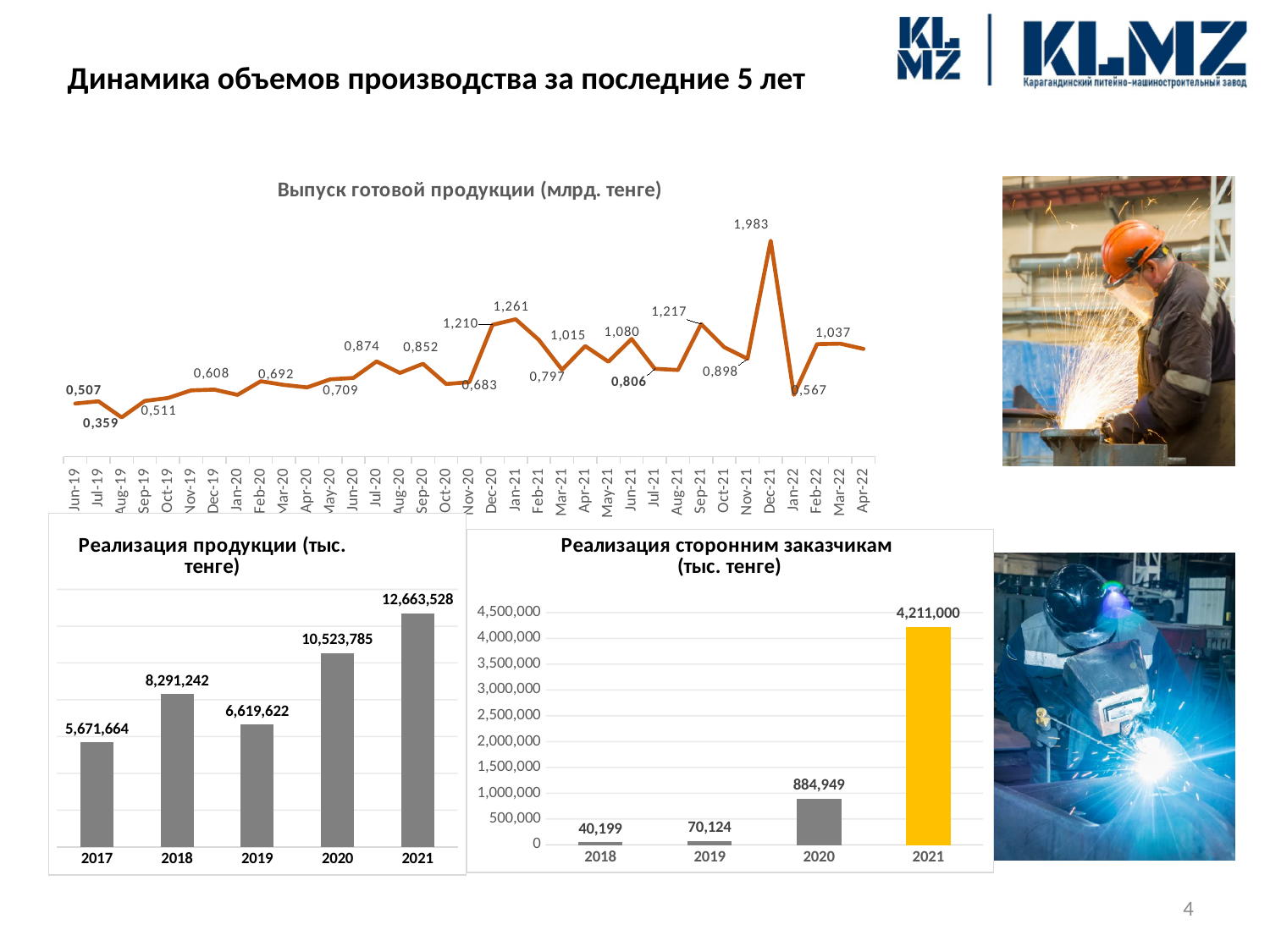
In the chart 'Реализация сторонним заказчикам (тыс. тенге)', is the value for 2021 greater or less than 4,000,000? greater In the chart 'Реализация продукции (тыс. тенге)', which year has the lowest value? 2017 In the chart 'Реализация сторонним заказчикам (тыс. тенге)', what is the difference between the 2019 and 2018 values? 29,925 How many years are shown in the chart 'Реализация сторонним заказчикам (тыс. тенге)'? 4 In the chart 'Реализация продукции (тыс. тенге)', what is the difference between the 2021 and 2020 values? 2,139,743 In the chart 'Реализация сторонним заказчикам (тыс. тенге)', do the values rise or fall from 2018 to 2021? rise In the chart 'Выпуск готовой продукции (млрд. тенге)', what is the highest labelled value? 1,983 In the chart 'Реализация продукции (тыс. тенге)', which year has the highest value? 2021 In the chart 'Реализация продукции (тыс. тенге)', which year has the larger value, 2018 or 2019? 2018 What kind of chart is 'Выпуск готовой продукции (млрд. тенге)'? line chart In the chart 'Реализация сторонним заказчикам (тыс. тенге)', what is the value for 2020? 884,949 In the chart 'Реализация продукции (тыс. тенге)', what is the value for 2020? 10,523,785